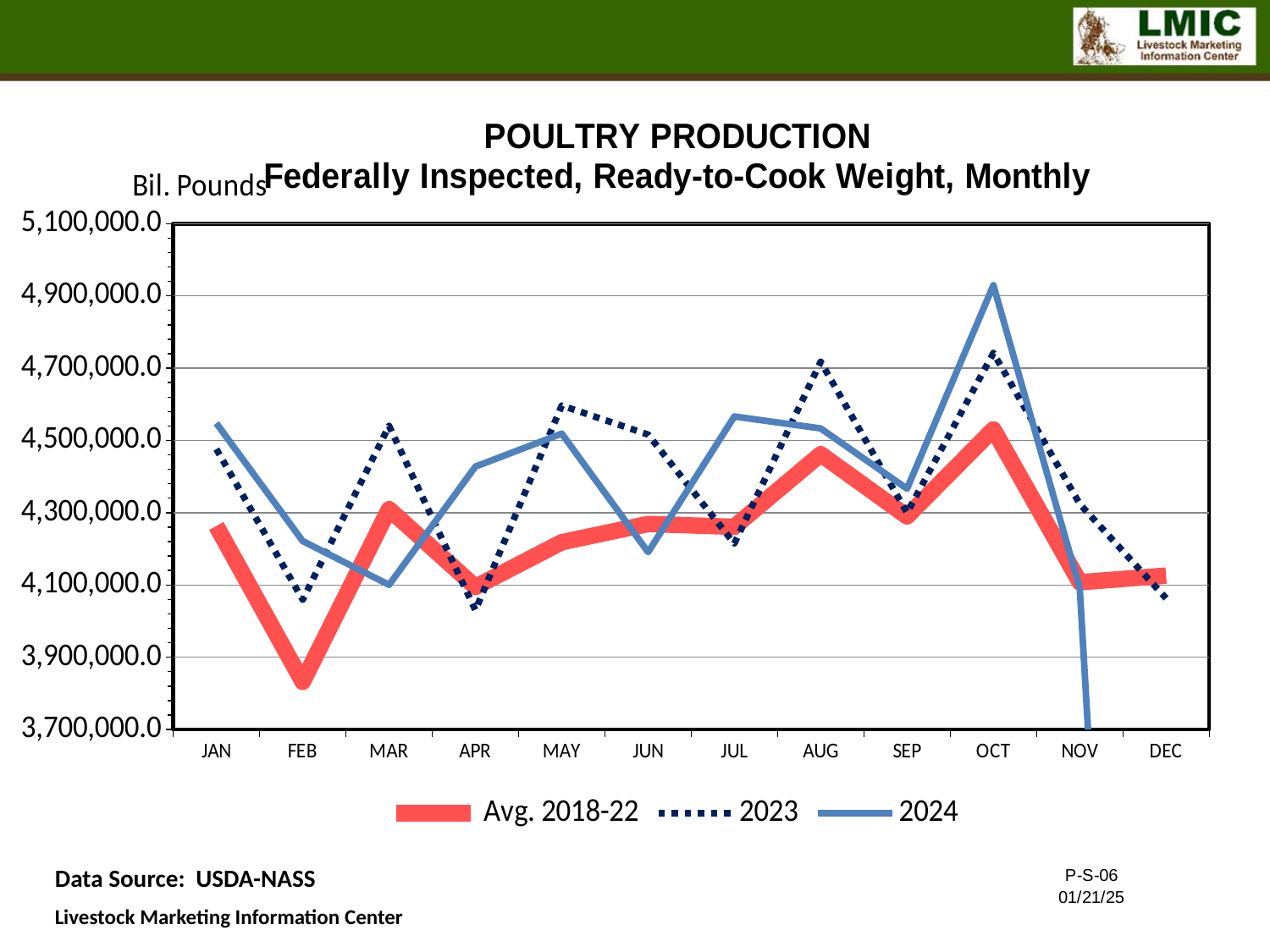
In JAN, which series is higher: 2024 or Avg. 2018-22? 2024 In JUN, which series is higher: 2023 or 2024? 2023 In which month is the Avg. 2018-22 series at its lowest? FEB How many months are shown along the x axis? 12 Is the 2023 value for AUG greater or less than 4,500,000.0? greater What kind of chart is shown on the slide? line chart Does the Avg. 2018-22 series rise or fall from OCT to NOV? fall In which month does the 2024 series reach its highest value? OCT Is the 2024 value for OCT greater or less than 4,700,000.0? greater What unit label is shown above the y axis? Bil. Pounds Is the Avg. 2018-22 value for FEB greater or less than 3,900,000.0? less How many series does the legend list? 3